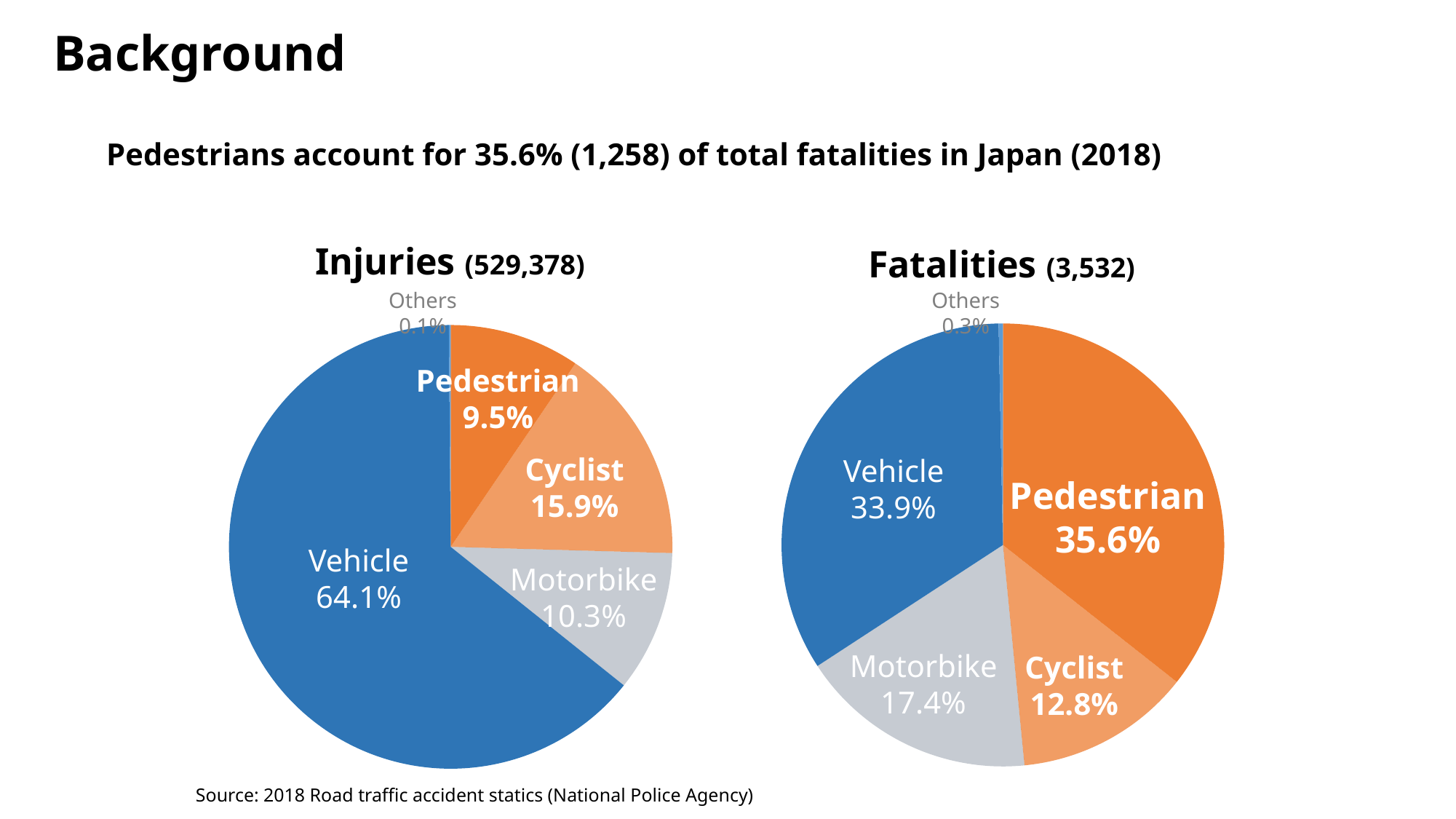
What total number of fatalities is shown in the title of the Fatalities chart? 3,532 In the Injuries pie chart, what is the share for Others? 0.1% In the Fatalities pie chart, which category has the largest share? Pedestrian In the Injuries pie chart, which is larger: the Cyclist share or the Motorbike share? Cyclist In the Fatalities pie chart, what is the difference between the Pedestrian share and the Vehicle share? 1.7% In the Injuries pie chart, what share do Vehicles account for? 64.1% In the Injuries pie chart, which category has the smallest share? Others In the Injuries pie chart, what is the share for Cyclists? 15.9% In the Fatalities pie chart, what share do Pedestrians account for? 35.6% In the Fatalities pie chart, what is the share for Motorbikes? 17.4% What type of chart is used for Injuries? Pie chart How many categories are shown in the Fatalities pie chart? 5